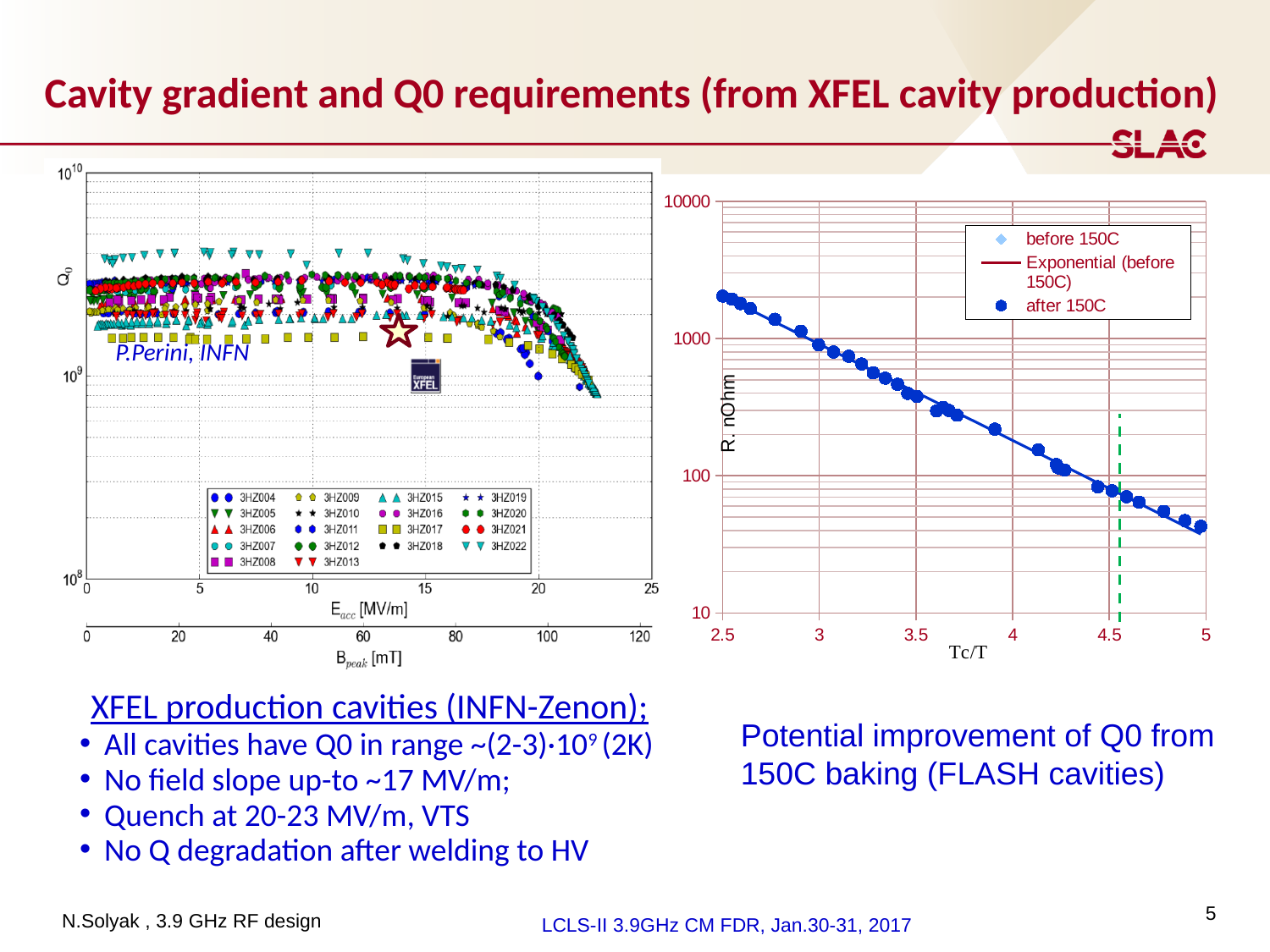
In the right-hand chart (R, nOhm versus Tc/T), is the value at Tc/T = 4 greater or less than 100? greater In the left-hand chart (Q0 versus Eacc), how many series does the legend list? 18 What kind of chart is the right-hand chart (R, nOhm versus Tc/T)? scatter chart In the right-hand chart (R, nOhm versus Tc/T), is the value at Tc/T = 5 greater or less than 100? less In the left-hand chart (Q0 versus Eacc), do the Q0 values rise or fall as Eacc goes from 20 to 25 MV/m? fall In the right-hand chart, what is the highest value shown on the y axis? 10000 In the right-hand chart (R, nOhm versus Tc/T), is the value at Tc/T = 2.5 greater or less than 1000? greater In the right-hand chart (R, nOhm versus Tc/T), which is larger, the value at Tc/T = 3 or the value at Tc/T = 4.5? Tc/T = 3 In the left-hand chart (Q0 versus Eacc), what is the label of the lower x axis? Bpeak [mT] In the right-hand chart (R, nOhm versus Tc/T), do the values rise or fall as Tc/T increases? fall In the right-hand chart (R, nOhm versus Tc/T), how many entries does the legend list? 3 In the right-hand chart, what is the label of the y axis? R, nOhm